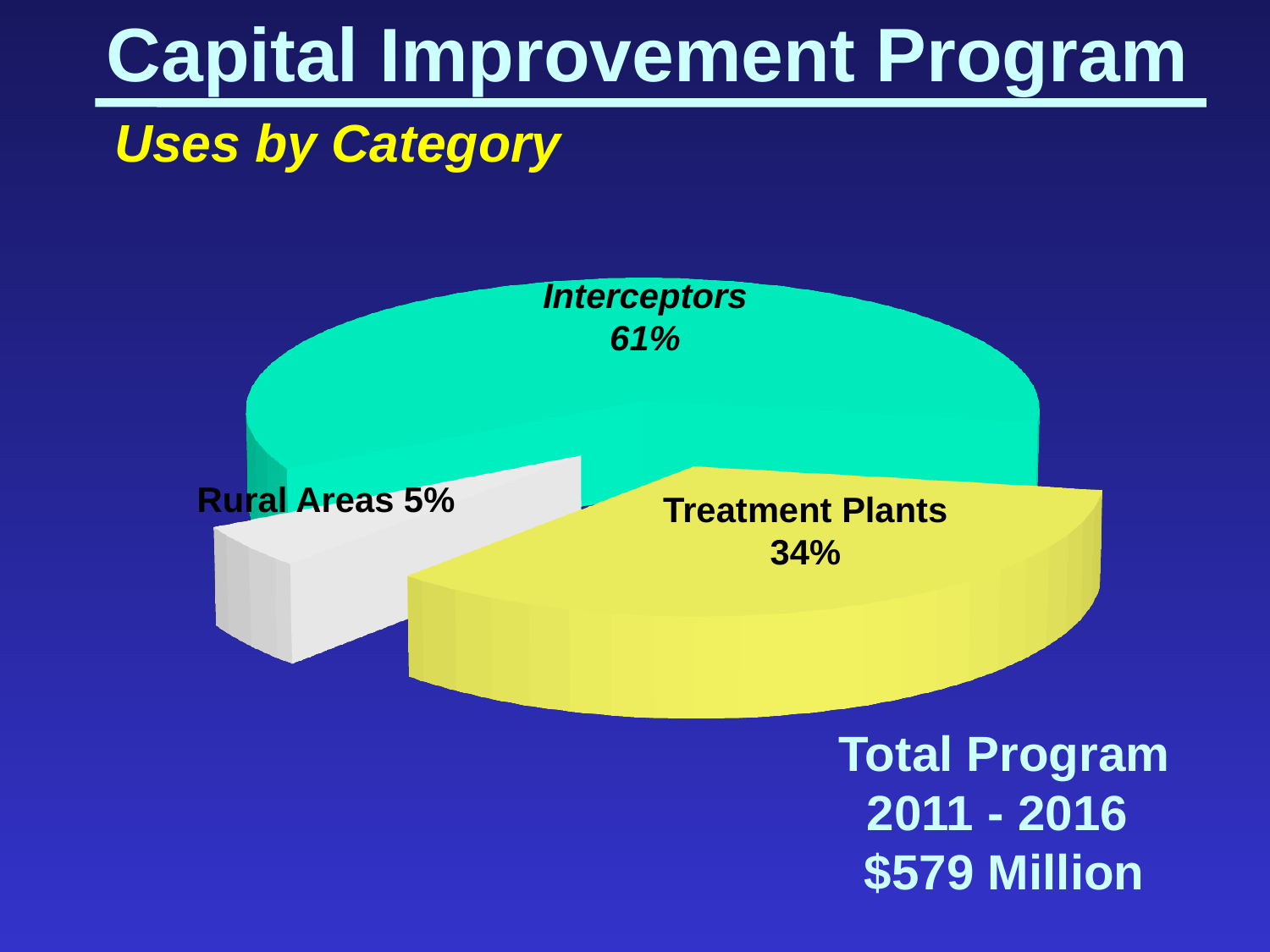
What kind of chart is shown on the slide? Pie chart What share of the pie does Interceptors represent? 61% Which is larger, the share for Treatment Plants or the share for Rural Areas? Treatment Plants What share of the pie does Rural Areas represent? 5% What is the difference in percentage points between Treatment Plants and Rural Areas? 29 What is the total program amount stated on the slide for 2011 - 2016? $579 Million How many categories are shown in the pie chart? 3 Which category has the smallest share of the pie? Rural Areas Which category has the largest share of the pie? Interceptors What colour is the Treatment Plants slice? Yellow What share of the pie does Treatment Plants represent? 34% What is the difference in percentage points between Interceptors and Treatment Plants? 27